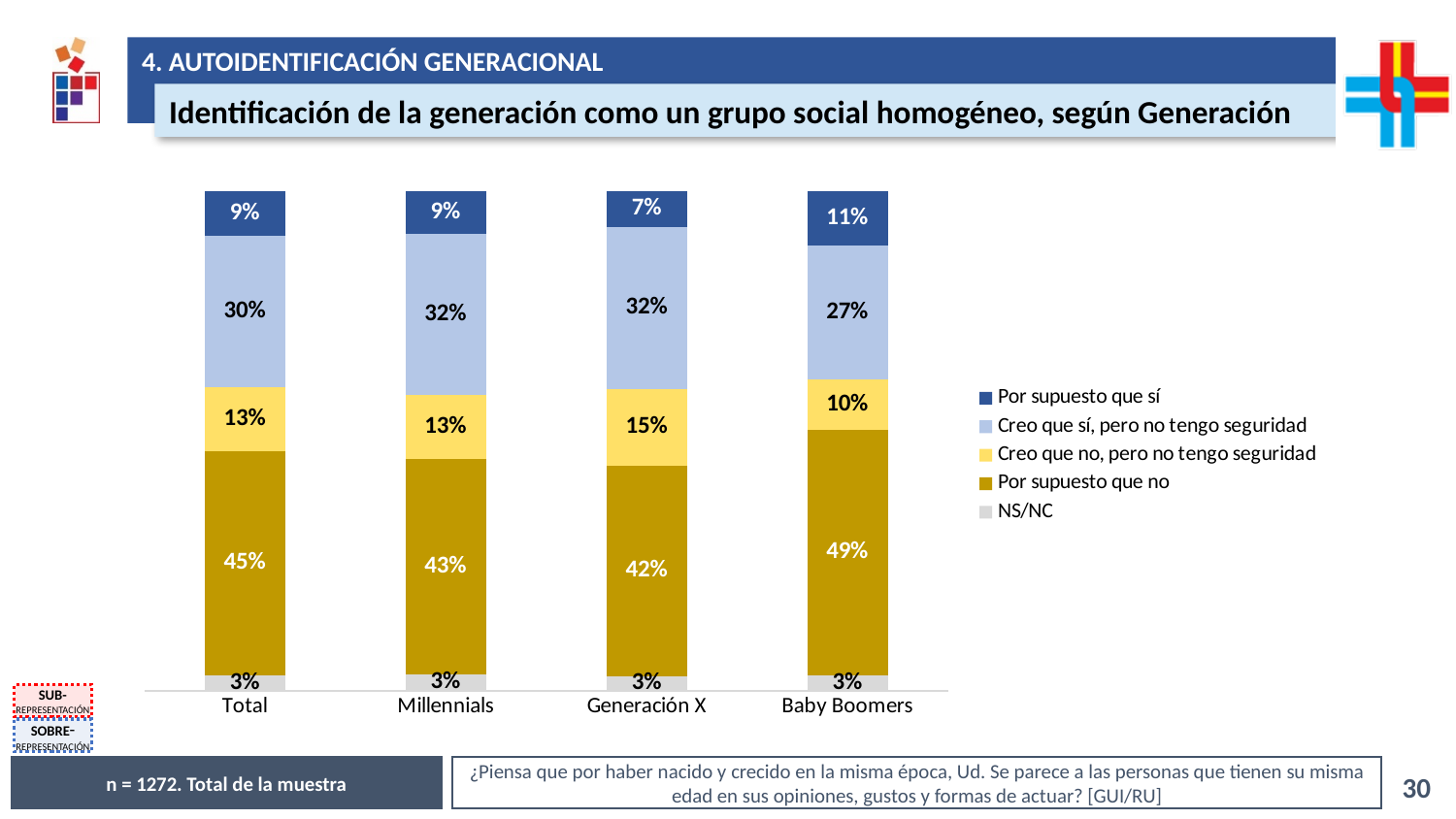
Which is larger: the 'Creo que sí, pero no tengo seguridad' value for Total or for Baby Boomers? Total Which category has the highest value for 'Por supuesto que sí'? Baby Boomers What is the value of 'Creo que sí, pero no tengo seguridad' for Millennials? 32% What is the value of 'Por supuesto que sí' for Generación X? 7% What is the value of 'Por supuesto que no' for Baby Boomers? 49% What is the total of the stacked bar for Millennials? 100% How many series does the legend list? 5 How many generation categories are shown on the x axis? 4 Which category has the lowest value for 'Por supuesto que no'? Generación X What kind of chart is shown on the slide? Stacked bar chart What is the difference between the 'Por supuesto que no' values for Baby Boomers and Generación X? 7% What is the value of 'Creo que no, pero no tengo seguridad' for Total? 13%